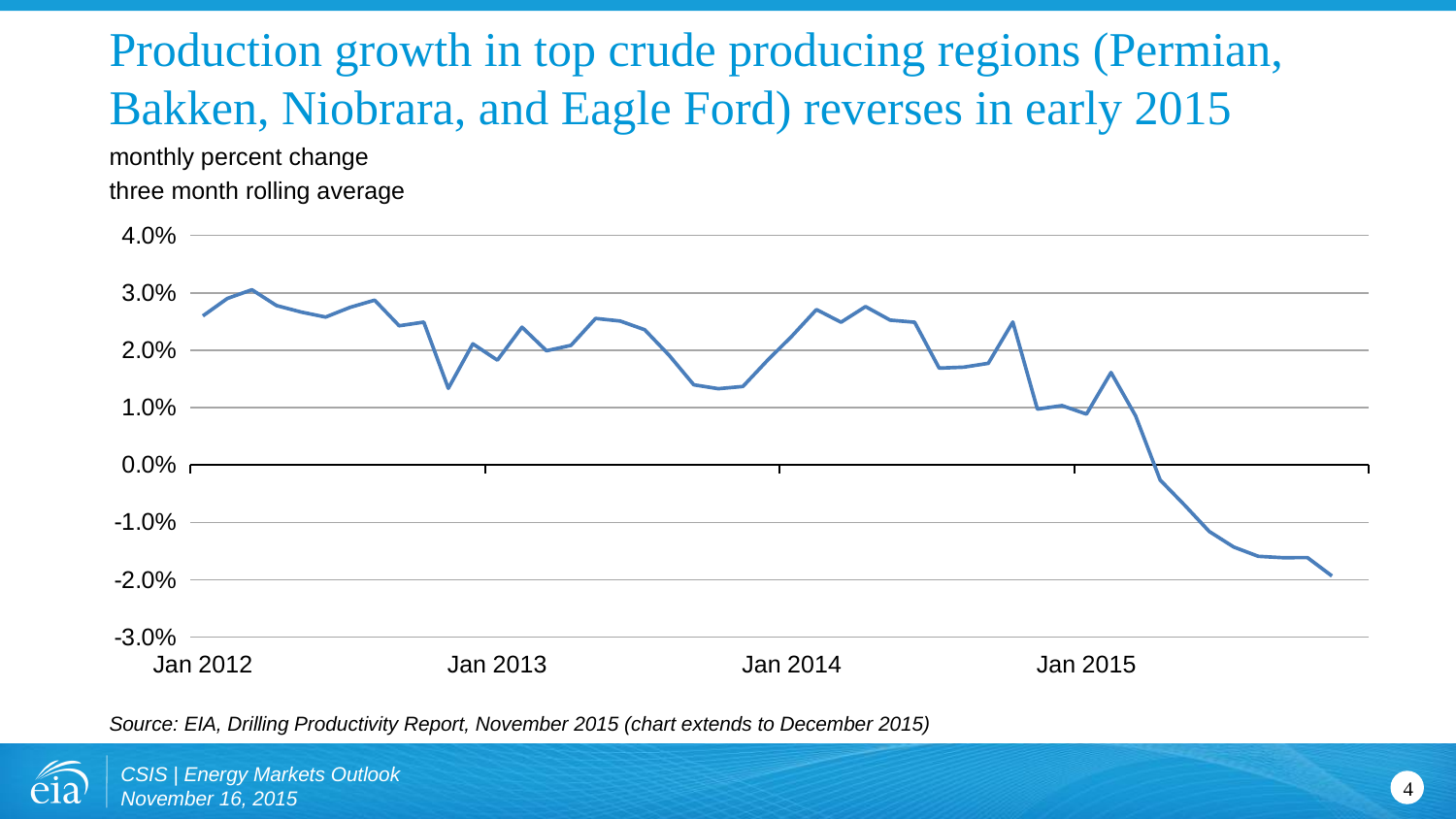
Does the plotted value rise or fall between Jan 2015 and the end of the chart? fall What does the y axis of the chart measure, according to the subtitle? monthly percent change, three month rolling average Which is larger, the value at Jan 2012 or the value at Jan 2015? Jan 2012 Is the value at the last point of the chart (December 2015) greater or less than -1.0%? less How many lines (series) are plotted on the chart? 1 Is the lowest value on the chart greater or less than -3.0%? greater What is the source cited for the chart? EIA, Drilling Productivity Report, November 2015 Overall, is the value at the end of the chart higher or lower than at Jan 2012? lower Is the value at Jan 2015 greater or less than 2.0%? less What kind of chart is shown on the slide? line chart